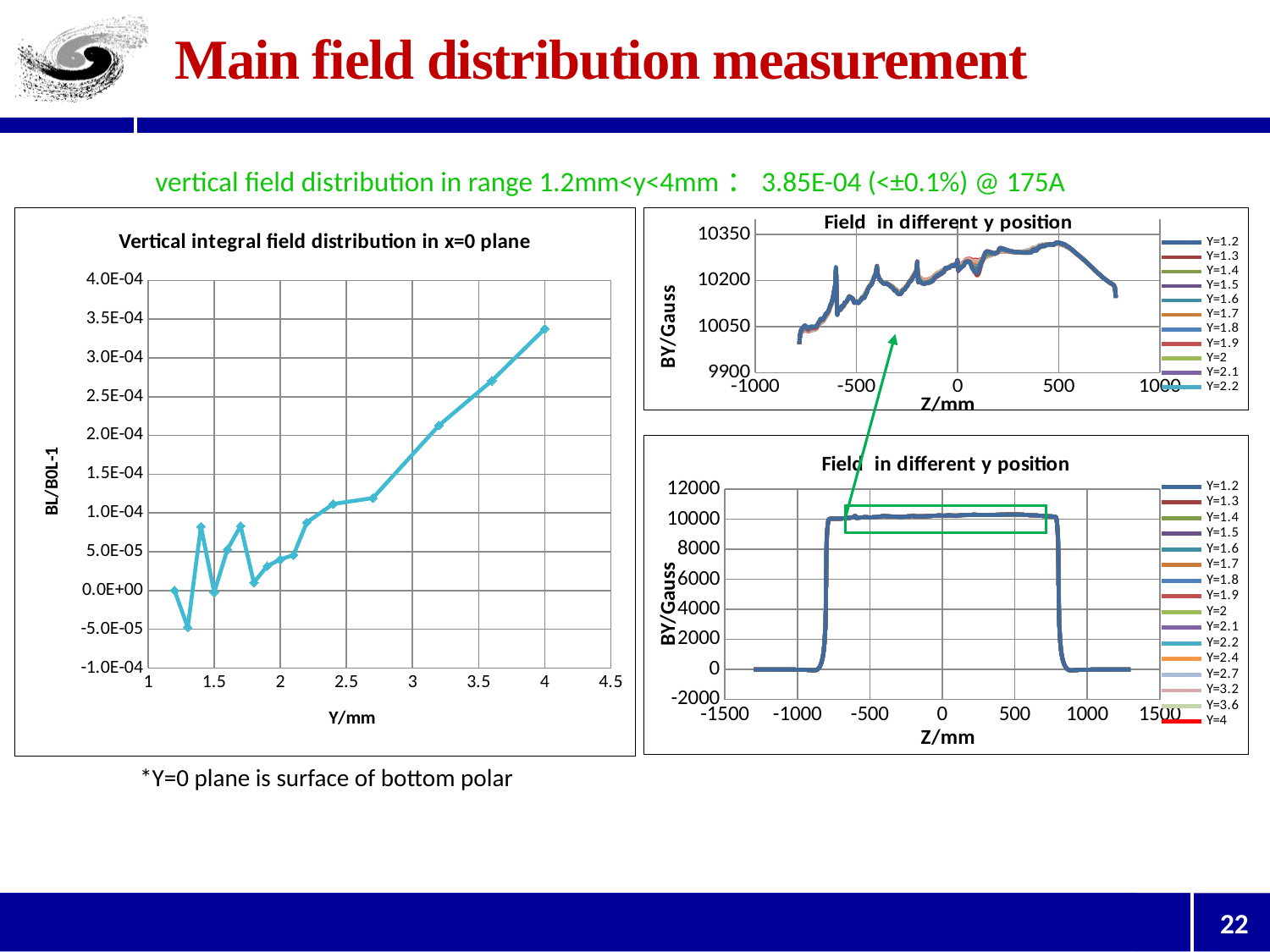
What is the y-axis label of the bottom-right 'Field in different y position' chart? BY/Gauss In the 'Vertical integral field distribution in x=0 plane' chart, at which Y/mm value is BL/B0L-1 highest? 4 In the 'Vertical integral field distribution in x=0 plane' chart, which is larger: the value at Y=3.2 or the value at Y=2.4? Y=3.2 In the 'Vertical integral field distribution in x=0 plane' chart, do the values overall rise or fall as Y/mm increases from 2 to 4? rise In the 'Vertical integral field distribution in x=0 plane' chart, is the value at Y=4 greater or less than 3.0E-04? greater What kind of chart is the 'Vertical integral field distribution in x=0 plane' chart? line chart In the 'Vertical integral field distribution in x=0 plane' chart, is the value at Y=1.3 greater or less than 0.0E+00? less In the 'Vertical integral field distribution in x=0 plane' chart, is the value at Y=3.6 greater or less than 2.5E-04? greater How many series does the legend of the top-right 'Field in different y position' chart list? 11 How many series does the legend of the bottom-right 'Field in different y position' chart list? 16 In the 'Vertical integral field distribution in x=0 plane' chart, at which Y/mm value is BL/B0L-1 lowest? 1.3